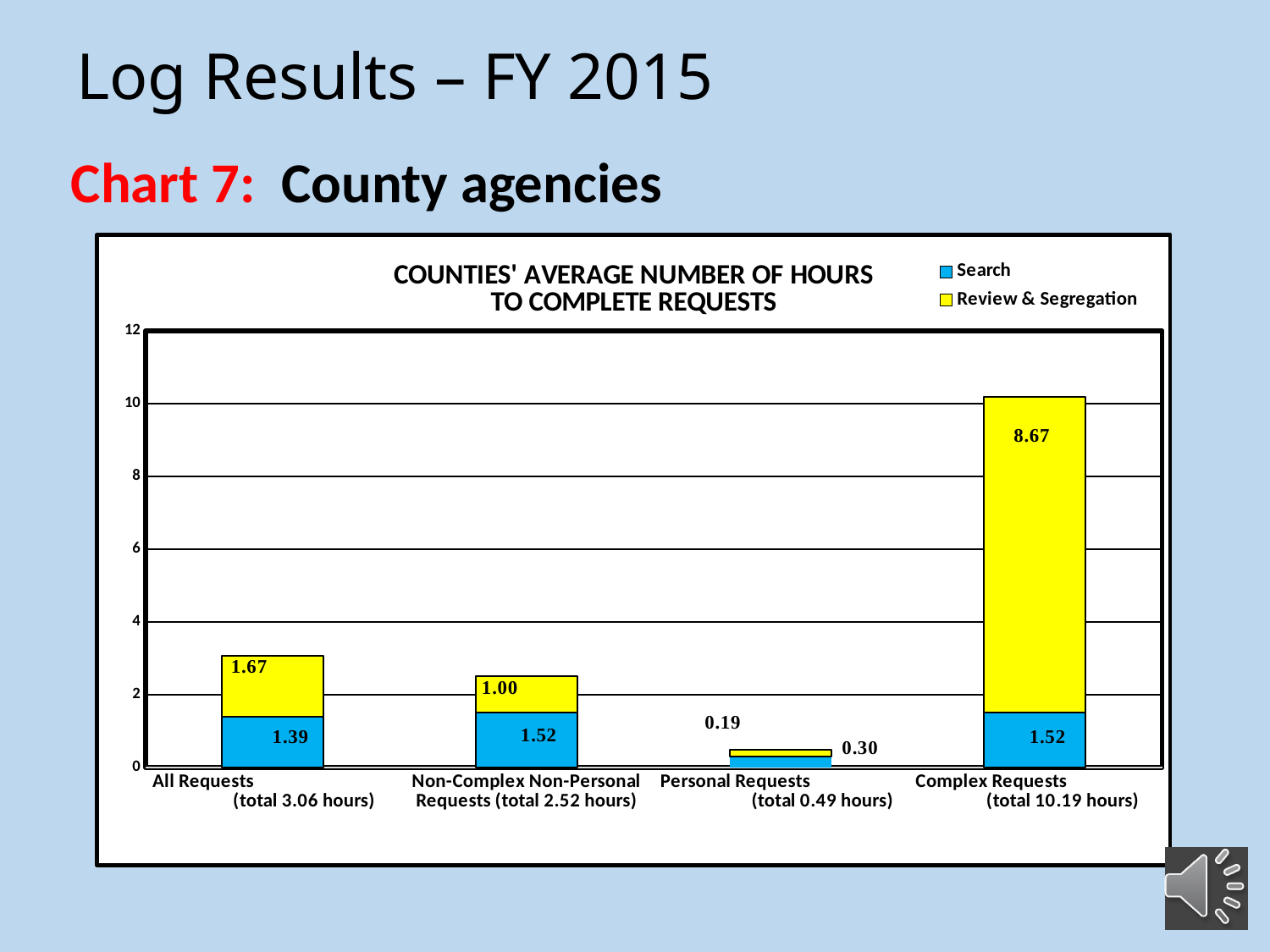
Which is larger for All Requests, the Search value or the Review & Segregation value? Review & Segregation What is the Review & Segregation value for Complex Requests? 8.67 What is the Search value for All Requests? 1.39 What type of chart is shown on the slide? stacked bar chart How many series does the legend list? 2 What is the difference between the Review & Segregation value and the Search value for Complex Requests? 7.15 What is the total number of hours for Non-Complex Non-Personal Requests? 2.52 hours What is the Search value for Complex Requests? 1.52 How many request categories are shown on the x axis? 4 Which category has the lowest total number of hours? Personal Requests Which category has the highest total number of hours? Complex Requests What is the Review & Segregation value for Non-Complex Non-Personal Requests? 1.00